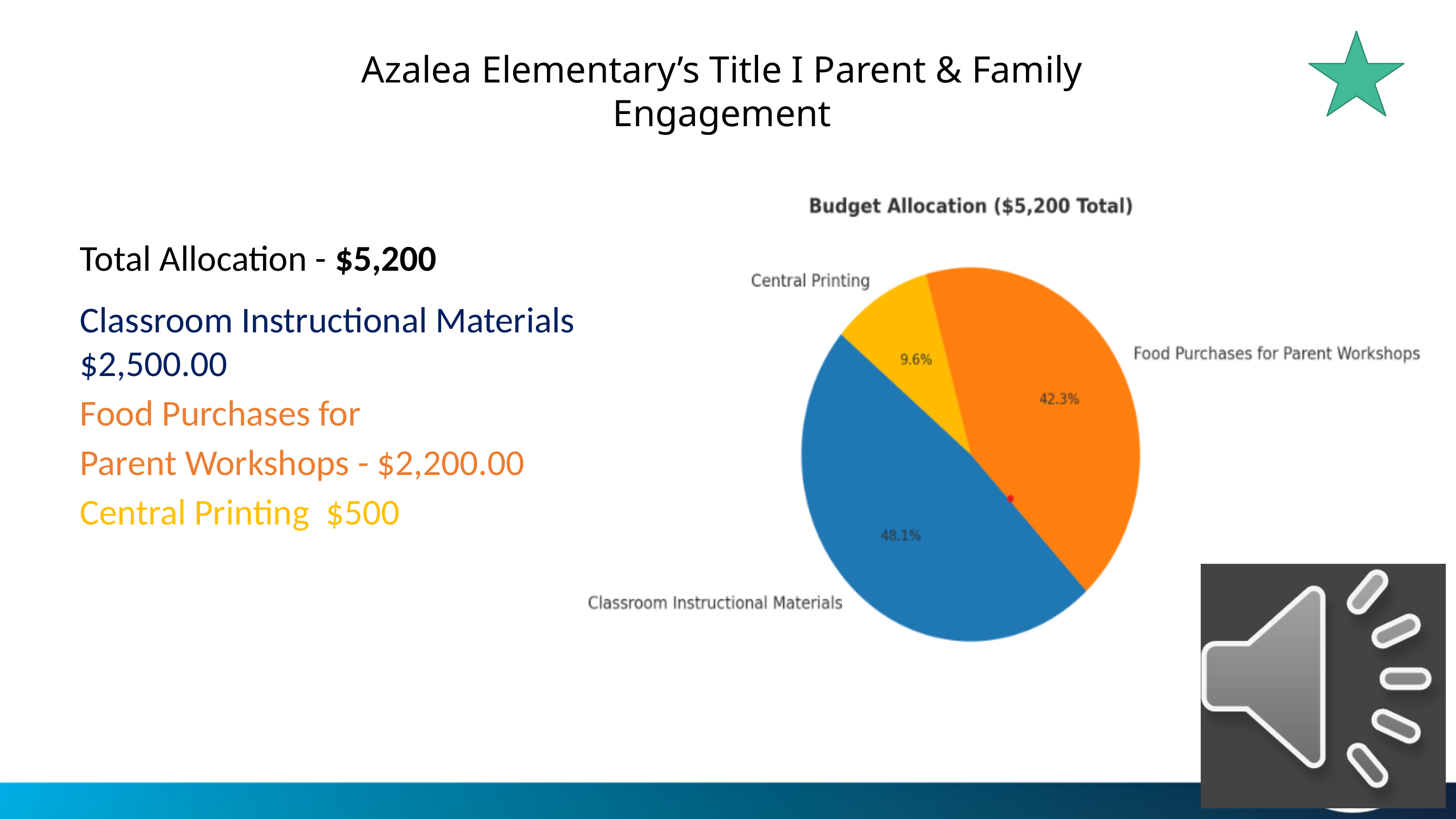
Which is larger, the share for Classroom Instructional Materials or the share for Central Printing? Classroom Instructional Materials What is the difference in percentage points between the Classroom Instructional Materials share and the Food Purchases for Parent Workshops share? 5.8 Which category has the smallest share of the pie? Central Printing What percentage of the pie is Classroom Instructional Materials? 48.1% What is the title of the chart? Budget Allocation ($5,200 Total) How many slices does the pie chart have? 3 Which category has the largest share of the pie? Classroom Instructional Materials What type of chart is shown on the slide? pie chart What percentage of the pie is Central Printing? 9.6% What percentage of the pie is Food Purchases for Parent Workshops? 42.3% What total budget is stated in the chart title? $5,200 What colour is the Central Printing slice? yellow